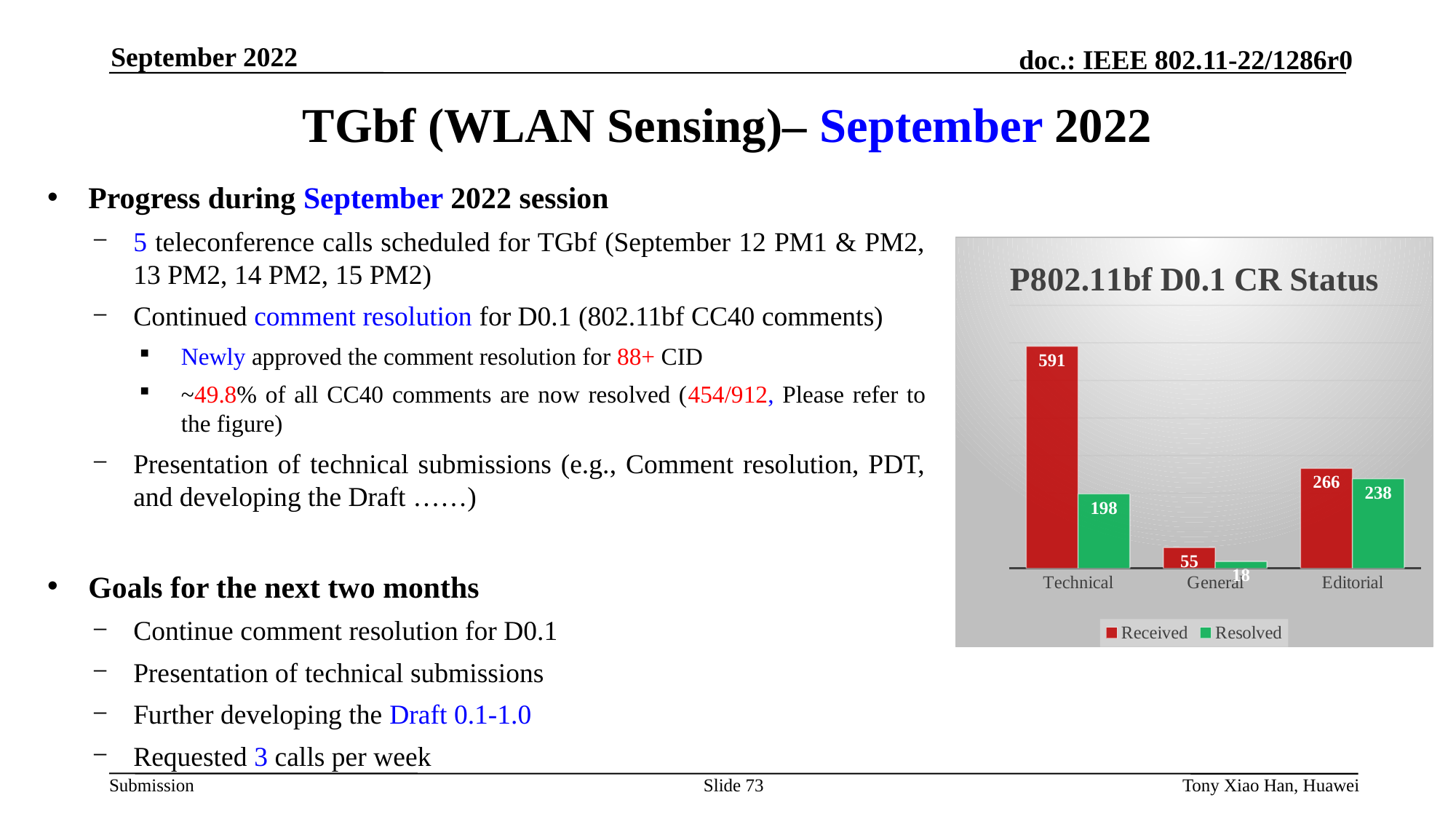
What is the Received value for Technical in the P802.11bf D0.1 CR Status chart? 591 How many series does the legend of the P802.11bf D0.1 CR Status chart list? 2 What colour are the Resolved bars in the P802.11bf D0.1 CR Status chart? green What is the difference between Received and Resolved for Editorial in the P802.11bf D0.1 CR Status chart? 28 What is the difference between Received and Resolved for Technical in the P802.11bf D0.1 CR Status chart? 393 How many categories are shown on the x axis of the P802.11bf D0.1 CR Status chart? 3 Which category has the highest Received value in the P802.11bf D0.1 CR Status chart? Technical What kind of chart is the P802.11bf D0.1 CR Status chart? bar chart What is the Resolved value for Editorial in the P802.11bf D0.1 CR Status chart? 238 What is the Resolved value for General in the P802.11bf D0.1 CR Status chart? 18 Is the Resolved value for Technical larger or smaller than the Received value for Editorial in the P802.11bf D0.1 CR Status chart? smaller Which category has the lowest Resolved value in the P802.11bf D0.1 CR Status chart? General